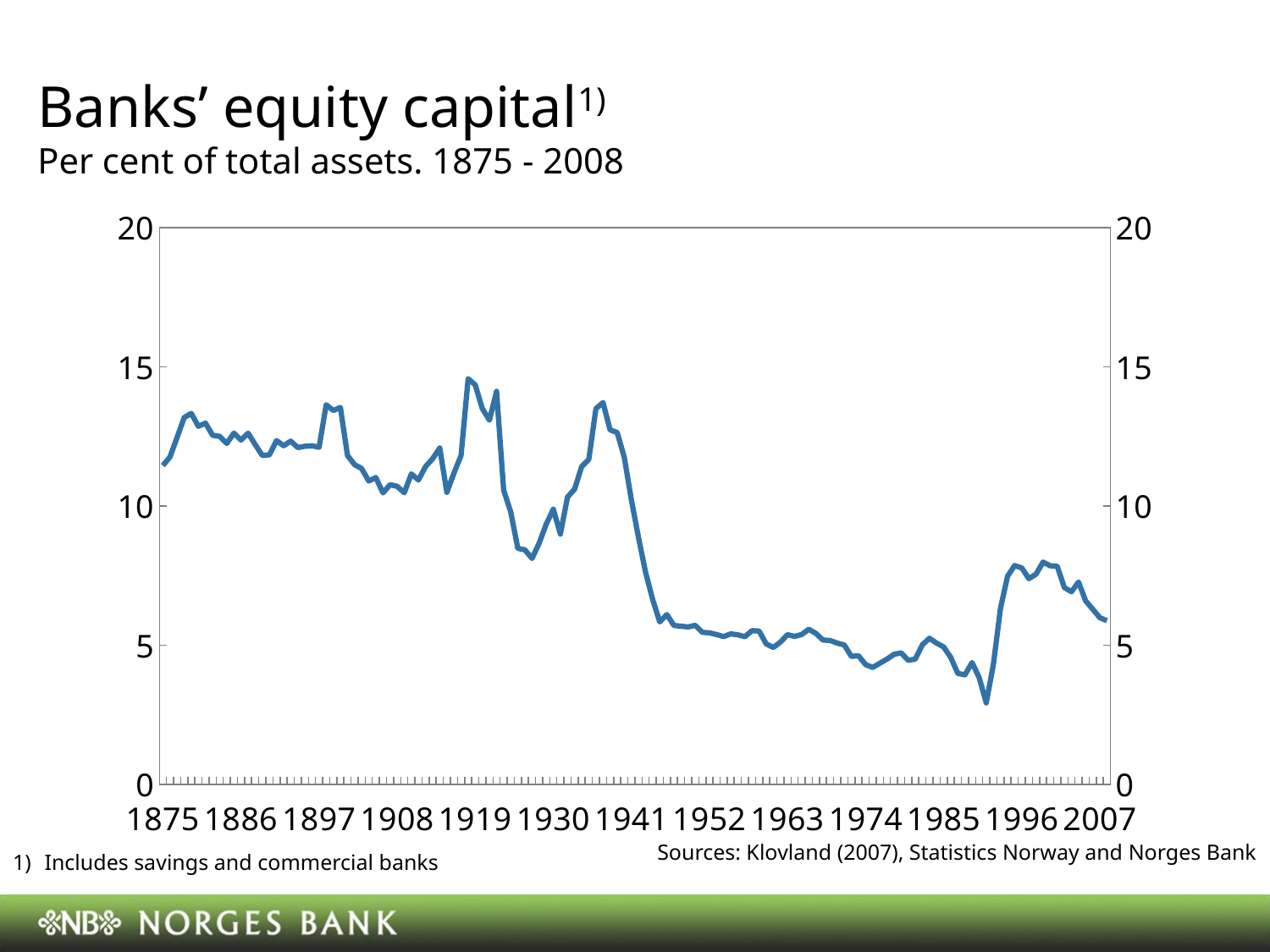
What unit does the subtitle say the values are measured in? Per cent of total assets What is the title of the chart? Banks' equity capital Is the value for 1875 greater or less than 10? greater Is the value for 1919 greater or less than 10? greater Between which two labelled years on the x axis does the line reach its lowest point? between 1985 and 1996 Is the value for 1952 greater or less than 10? less Overall, does the line rise or fall from 1875 to 2008? fall Which is larger, the value for 1875 or the value for 2007? 1875 What kind of chart is shown on the slide? line chart